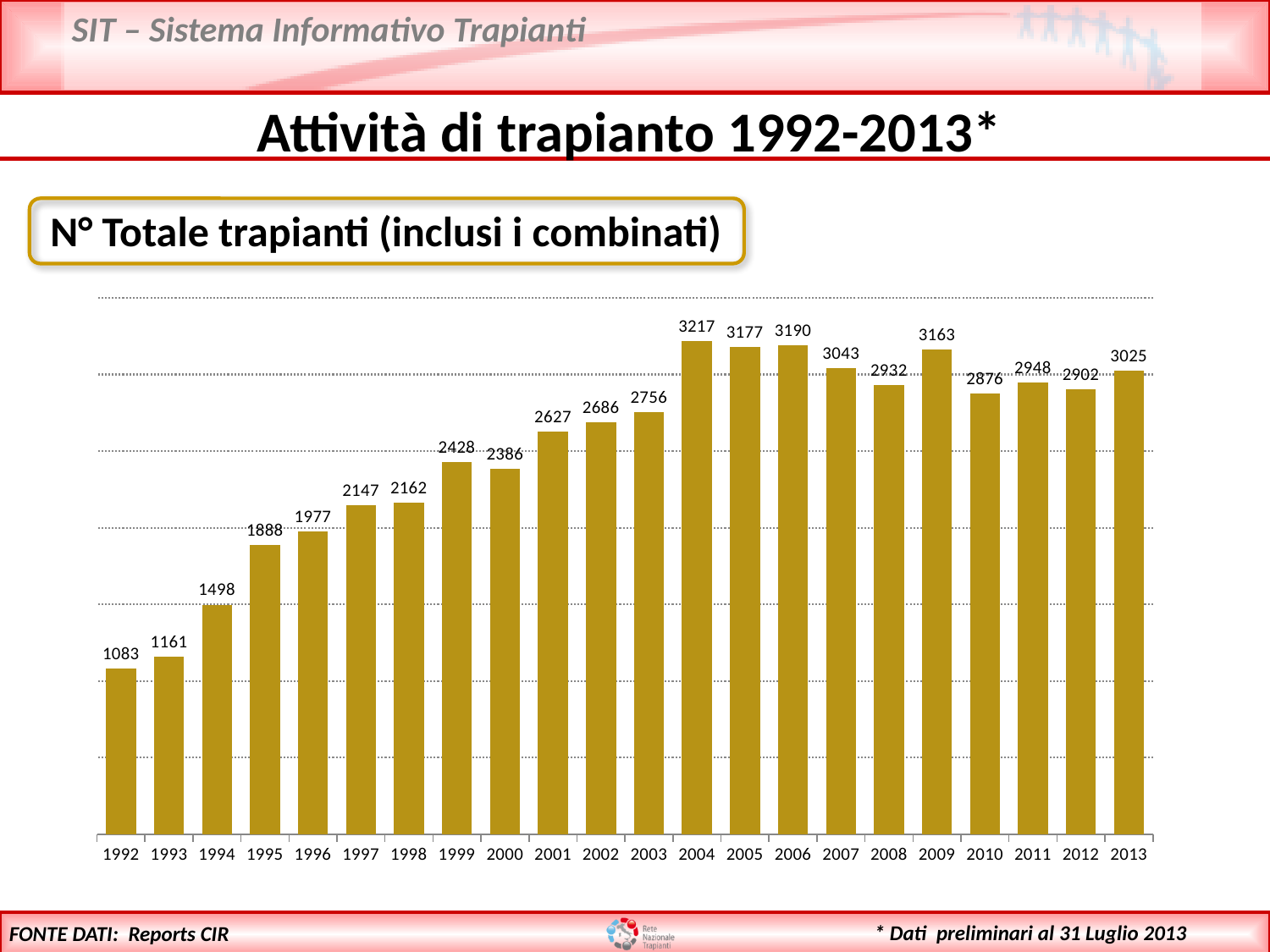
What is the number of total transplants shown for 2004? 3217 What value is shown for 2009? 3163 What is the difference between the values for 2004 and 2003? 461 What is the difference between the values for 2013 and 1992? 1942 What value is shown for 2013? 3025 What value is shown for 1992? 1083 Which is larger, the value for 1999 or the value for 2000? 1999 What kind of chart is shown on the slide? Bar chart How many years are shown on the x axis? 22 What is the title shown in the box above the chart? N° Totale trapianti (inclusi i combinati) Which year has the lowest number of transplants? 1992 Which year has the highest number of transplants? 2004